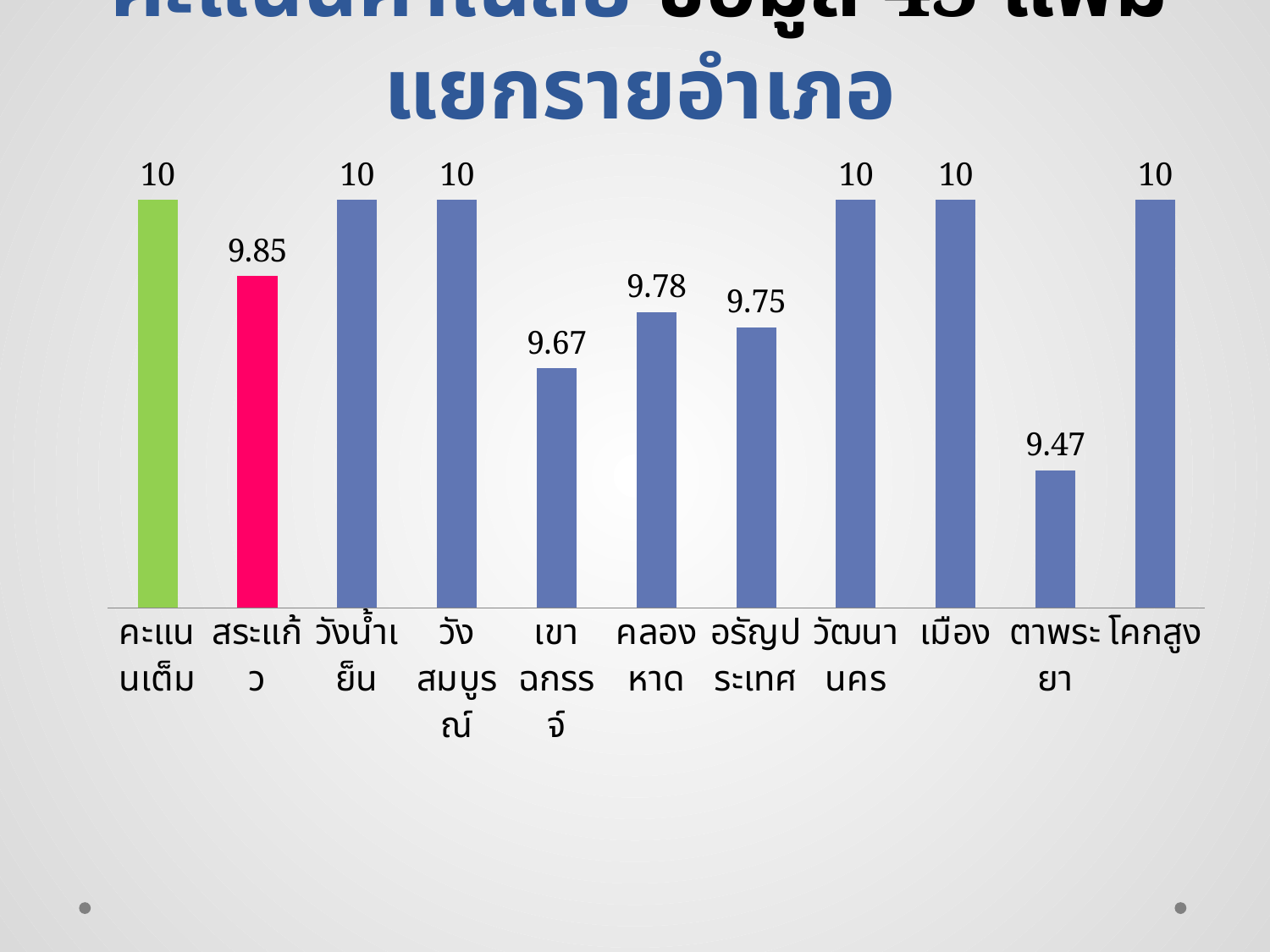
What kind of chart is shown on the slide? bar chart What is the difference between the values for คลองหาด and เขาฉกรรจ์? 0.11 What is the value shown for คลองหาด? 9.78 What is the value shown for อรัญประเทศ? 9.75 What is the value shown for สระแก้ว? 9.85 What is the difference between the values for คะแนนเต็ม and ตาพระยา? 0.53 What is the value shown for ตาพระยา? 9.47 How many bars (categories) are plotted in the chart? 11 What colour is the bar for สระแก้ว? pink Which category has the lowest value in the chart? ตาพระยา Which is larger, the value for คลองหาด or the value for อรัญประเทศ? คลองหาด What is the value shown for เขาฉกรรจ์? 9.67